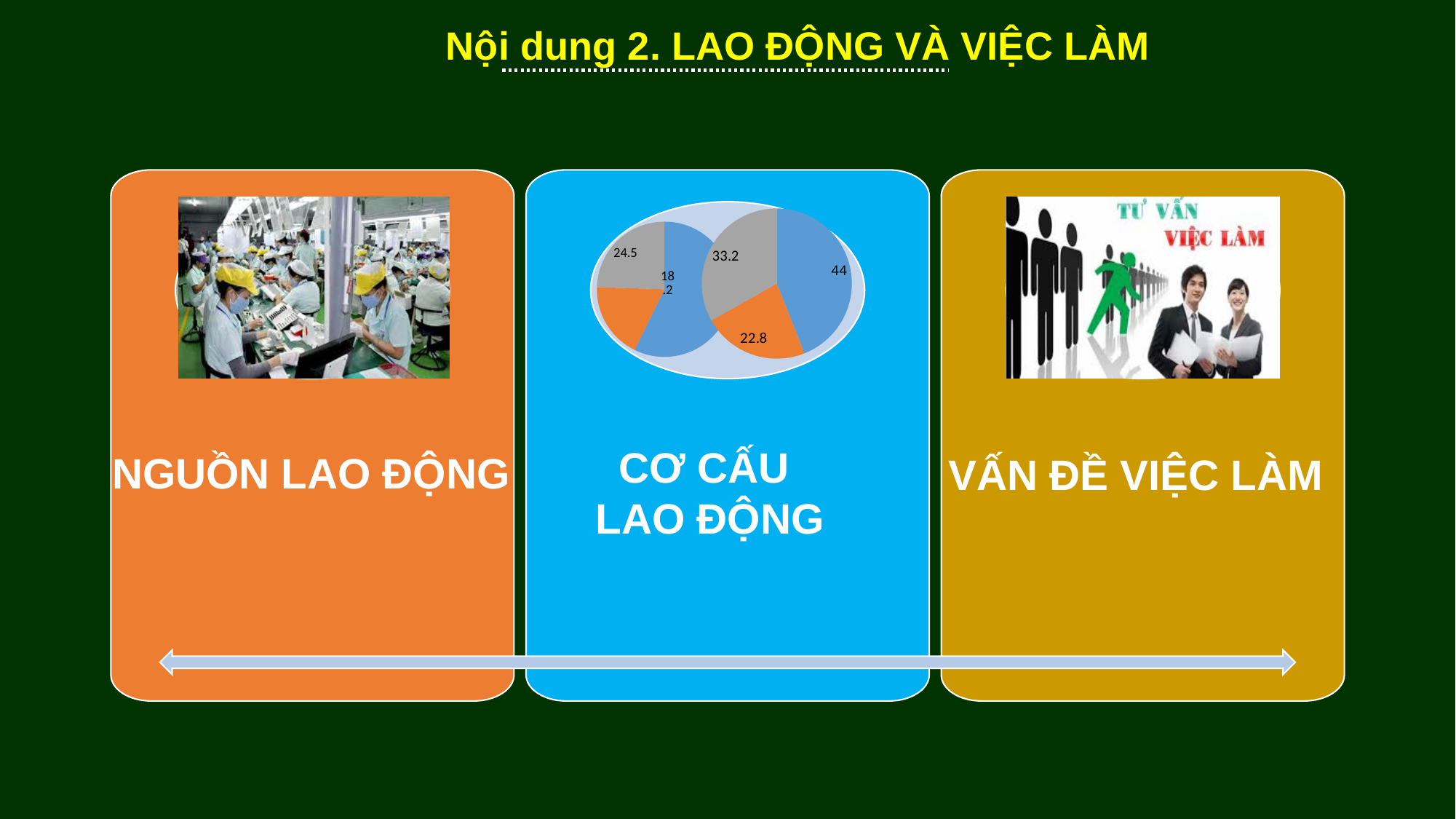
In the right-hand pie chart in the middle panel, what is the difference between the blue slice (44) and the grey slice (33.2)? 10.8 What kind of chart is shown in the middle panel (CƠ CẤU LAO ĐỘNG)? Pie chart How many slices does the right-hand pie chart in the middle panel have? 3 In the right-hand pie chart in the middle panel, which is larger: the grey slice or the orange slice? The grey slice (33.2) In the right-hand pie chart in the middle panel, which colour slice has the largest value? Blue (44) In the right-hand pie chart in the middle panel, what is the difference between the blue slice (44) and the orange slice (22.8)? 21.2 In the right-hand pie chart in the middle panel, what value is printed on the orange slice? 22.8 In the right-hand pie chart in the middle panel, what value is printed on the blue slice? 44 In the right-hand pie chart in the middle panel, what value is printed on the grey slice? 33.2 In the left-hand pie chart in the middle panel, what value is printed on the grey slice? 24.5 How many pie charts are shown in the middle panel of the slide? 2 In the right-hand pie chart in the middle panel, which colour slice has the smallest value? Orange (22.8)